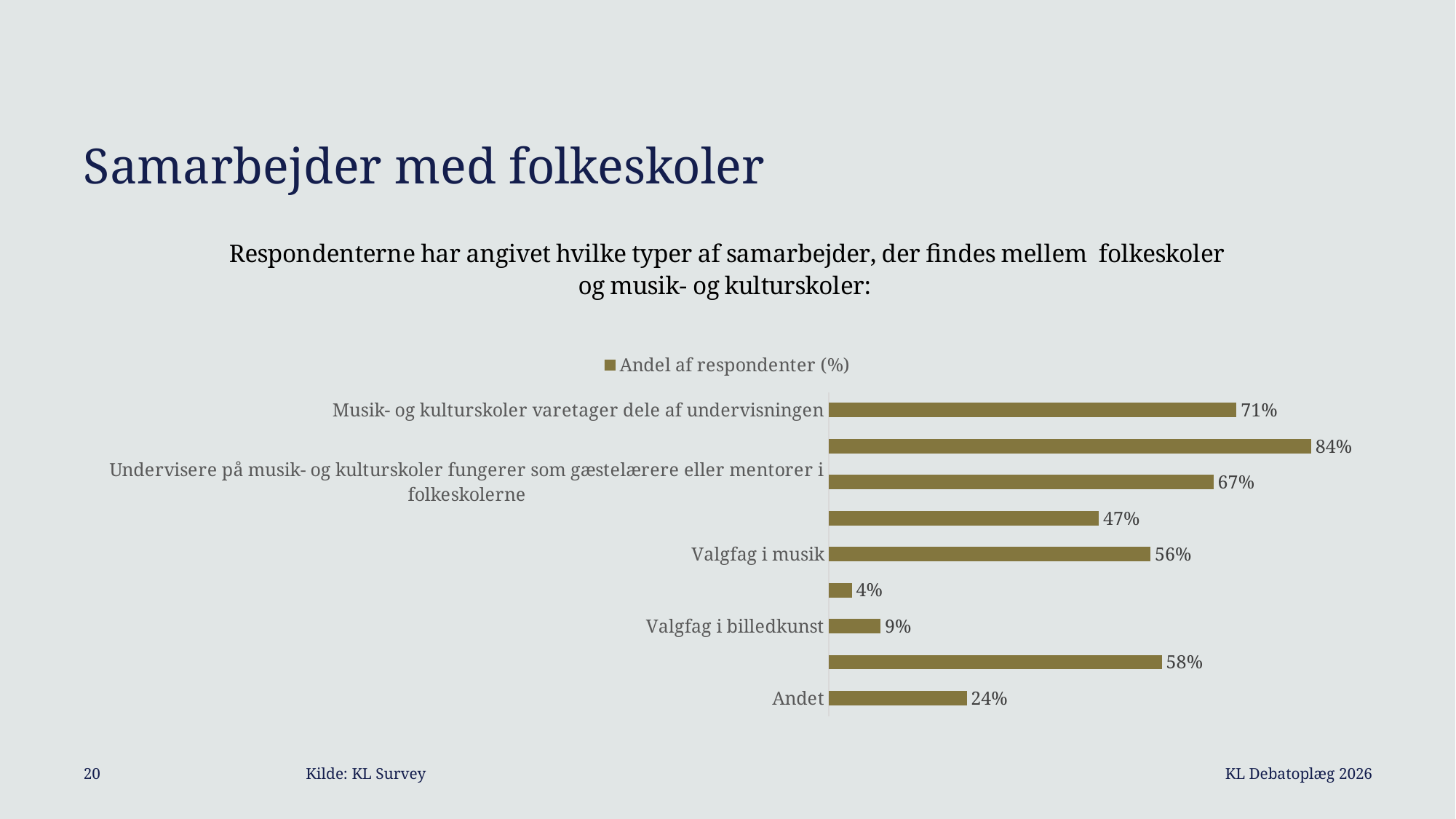
What is the value for "Valgfag i musik"? 56% What is the value for "Undervisere på musik- og kulturskoler fungerer som gæstelærere eller mentorer i folkeskolerne"? 67% How many bars are plotted on the chart? 9 What is the value for "Valgfag i billedkunst"? 9% What is the lowest value shown on the chart? 4% What is the value for "Musik- og kulturskoler varetager dele af undervisningen"? 71% What kind of chart is shown on the slide? Bar chart How many series does the legend list? 1 Which is larger, the value for "Andet" or the value for "Valgfag i billedkunst"? Andet What is the difference between the values for "Musik- og kulturskoler varetager dele af undervisningen" and "Valgfag i musik"? 15% What is the highest value shown on the chart? 84% What is the value for "Andet"? 24%